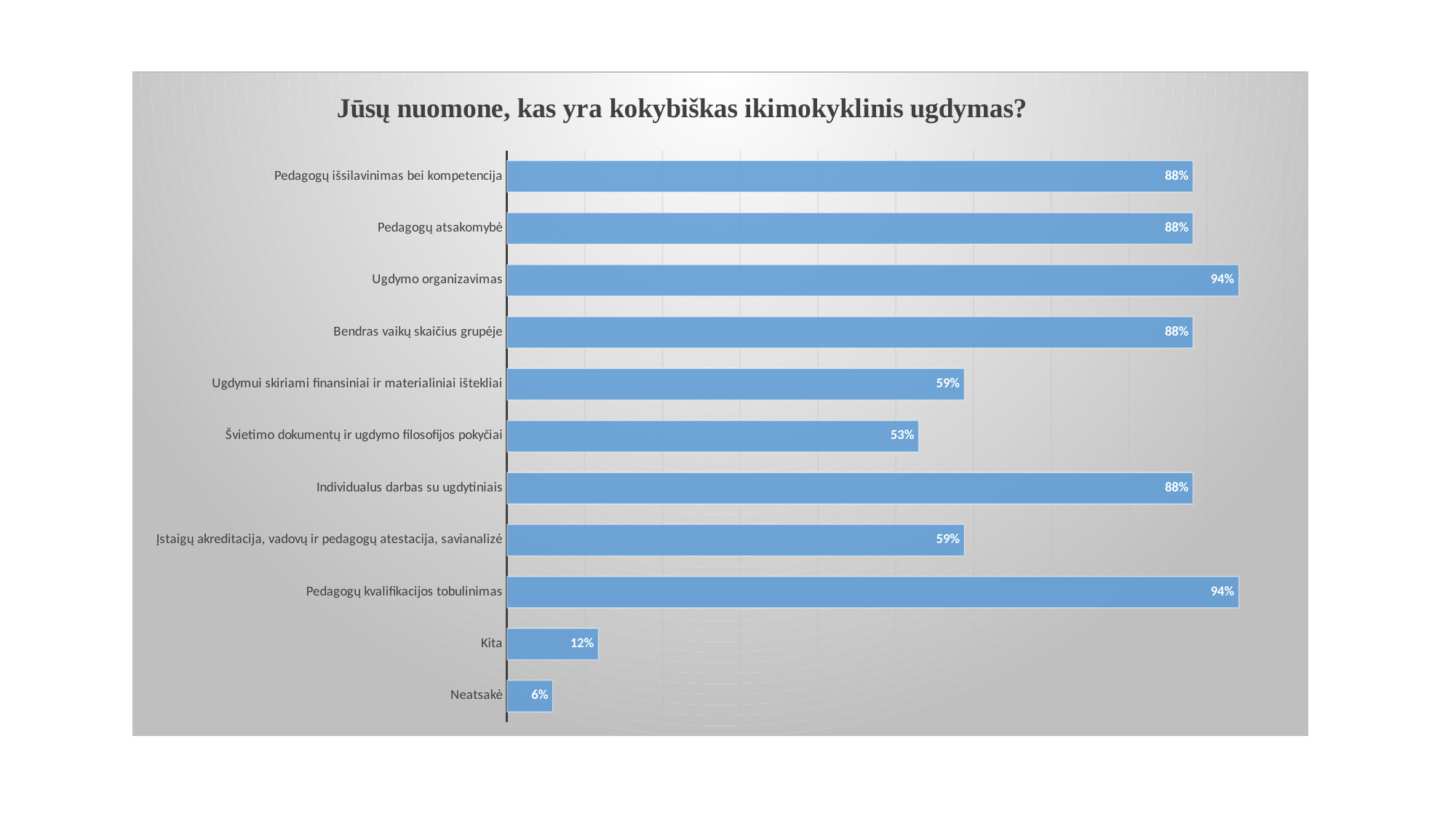
What is the difference between the values for Pedagogų kvalifikacijos tobulinimas and Kita? 82% What is the highest value shown in the chart? 94% What is the value for Ugdymui skiriami finansiniai ir materialiniai ištekliai? 59% What is the value for Kita? 12% Which category has the lowest value? Neatsakė What is the value for Švietimo dokumentų ir ugdymo filosofijos pokyčiai? 53% Which is larger, the value for Individualus darbas su ugdytiniais or the value for Įstaigų akreditacija, vadovų ir pedagogų atestacija, savianalizė? Individualus darbas su ugdytiniais What kind of chart is shown on the slide? Bar chart How many categories are shown in the chart? 11 What is the value for Ugdymo organizavimas? 94% What is the title of the chart? Jūsų nuomone, kas yra kokybiškas ikimokyklinis ugdymas? What is the difference between the values for Pedagogų atsakomybė and Švietimo dokumentų ir ugdymo filosofijos pokyčiai? 35%